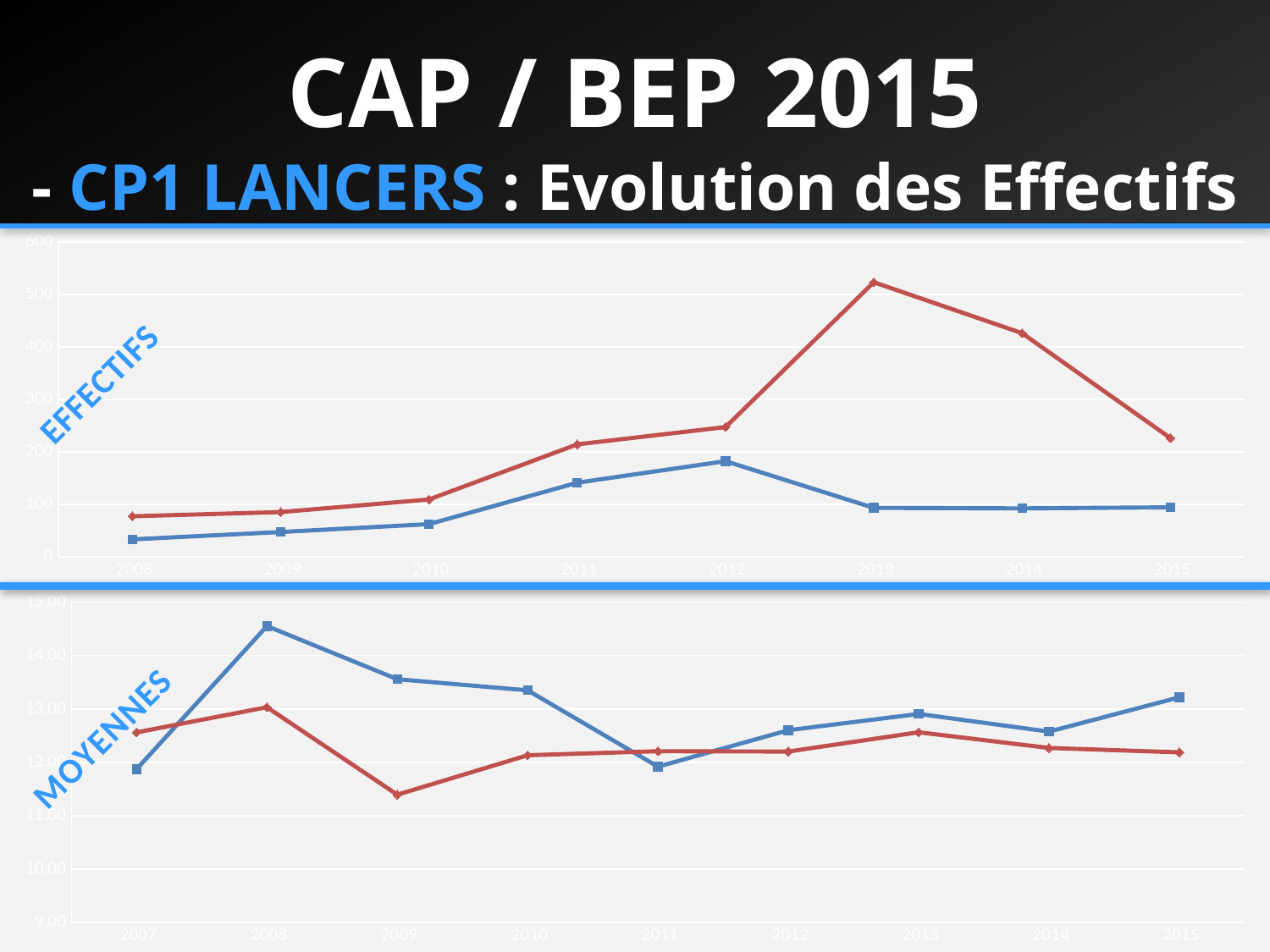
In the top chart (EFFECTIFS), in which year does the red line reach its highest value? 2013 What type of chart is the top chart labelled EFFECTIFS? Line chart In the bottom chart (MOYENNES), is the value of the blue line in 2008 greater or less than 14.00? greater In the bottom chart (MOYENNES), in which year does the red line reach its lowest value? 2009 In the top chart (EFFECTIFS), is the value of the red line in 2013 greater or less than 400? greater How many years are shown on the x axis of the top chart (EFFECTIFS)? 8 In the top chart (EFFECTIFS), is the value of the blue line in 2008 greater or less than 100? less In the bottom chart (MOYENNES), in which year does the blue line reach its highest value? 2008 How many years are shown on the x axis of the bottom chart (MOYENNES)? 9 In the top chart (EFFECTIFS), does the red line rise or fall between 2013 and 2015? Fall In the top chart (EFFECTIFS), which line has the larger value in 2013, the red line or the blue line? The red line In the top chart (EFFECTIFS), in which year does the blue line reach its highest value? 2012